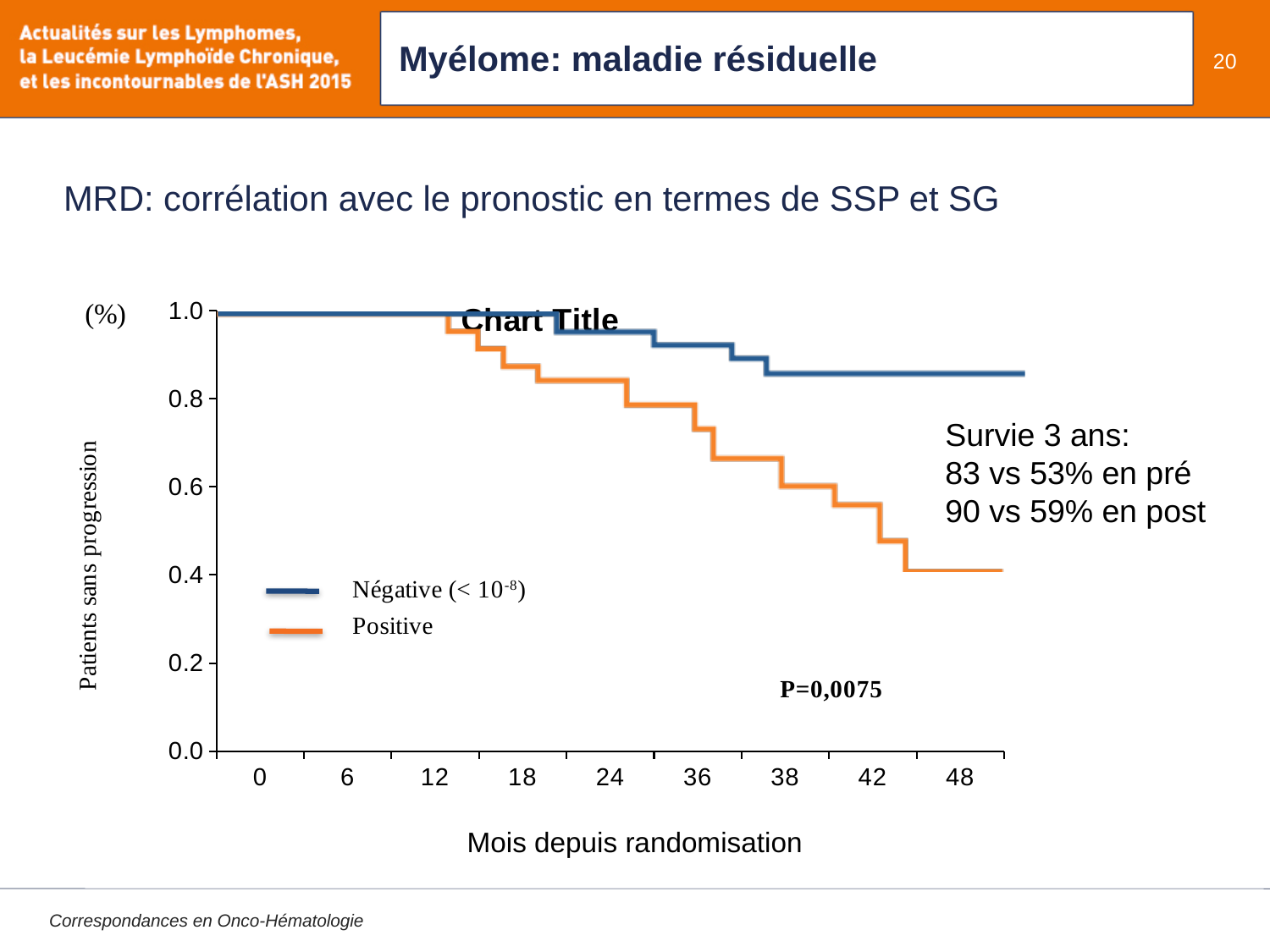
At the right end of the chart, which series has the higher value, Négative (< 10-8) or Positive? Négative (< 10-8) What kind of chart is shown on the slide? Line chart Which two series are listed in the chart legend? Négative (< 10-8) and Positive Do the values of the Négative (< 10-8) series rise or fall along the x axis? Fall Which series is drawn in orange, Négative (< 10-8) or Positive? Positive Is the value of the Positive series at 42 months greater or less than 0.8? less Is the value of the Positive series at 24 months greater or less than 0.6? greater Is the final value of the Positive series greater or less than 0.6? less Do the values of the Positive series rise or fall as months since randomisation increase? Fall How many series does the chart legend list? 2 What P value is printed on the chart? P=0,0075